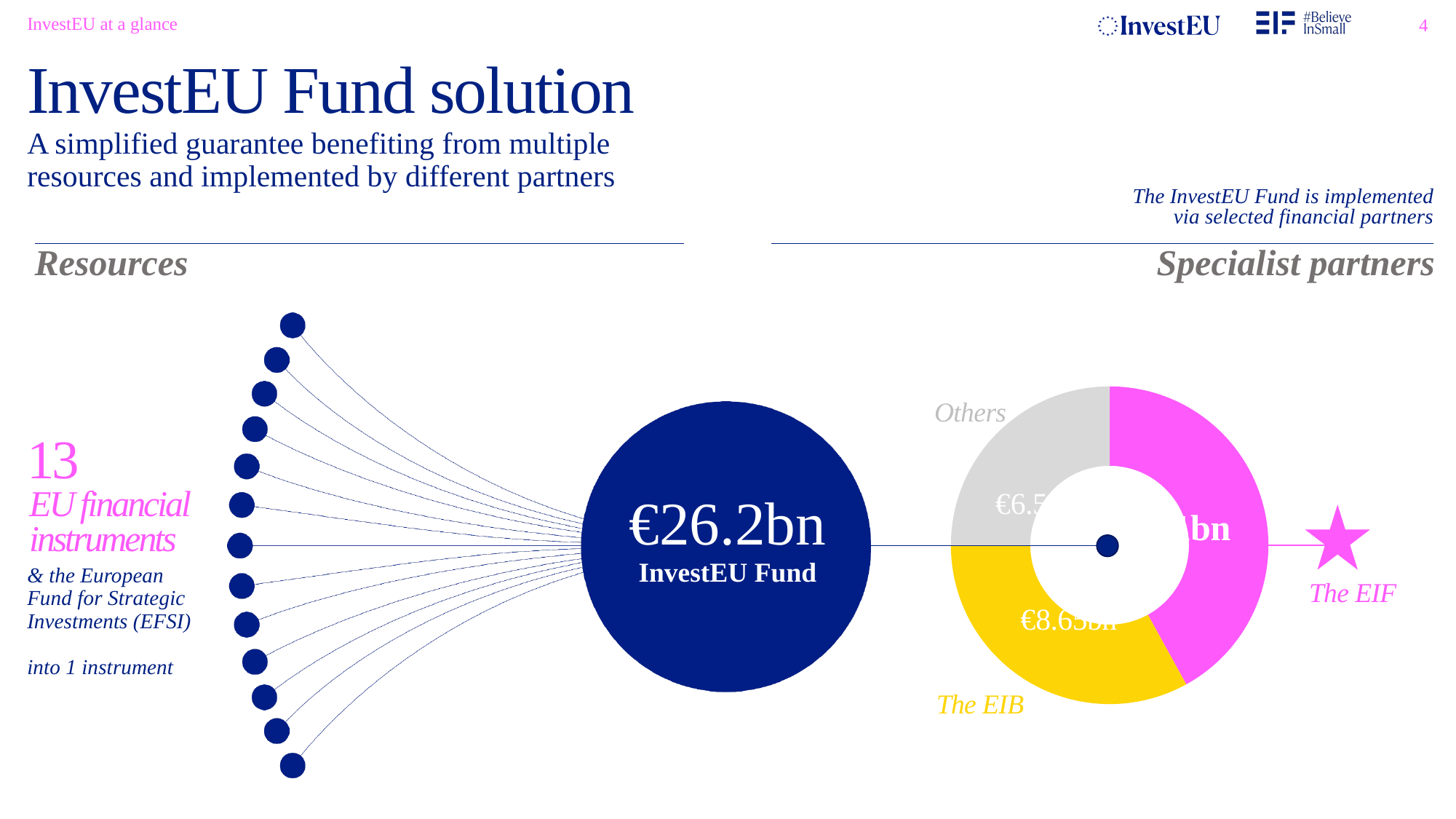
What colour represents The EIF in the Specialist partners donut chart? Pink What total amount is shown in the InvestEU Fund circle in the centre of the slide? €26.2bn In the Specialist partners donut chart, which slice is larger: The EIB or Others? The EIB What kind of chart is shown under 'Specialist partners'? Pie chart (donut) How many slices does the Specialist partners donut chart have? 3 In the Specialist partners donut chart, which slice is larger: The EIF or The EIB? The EIF Which partner has the largest slice in the Specialist partners donut chart? The EIF Which partner has the smallest slice in the Specialist partners donut chart? Others What value is shown for The EIB in the Specialist partners donut chart? €8.65bn What colour represents The EIB in the Specialist partners donut chart? Yellow